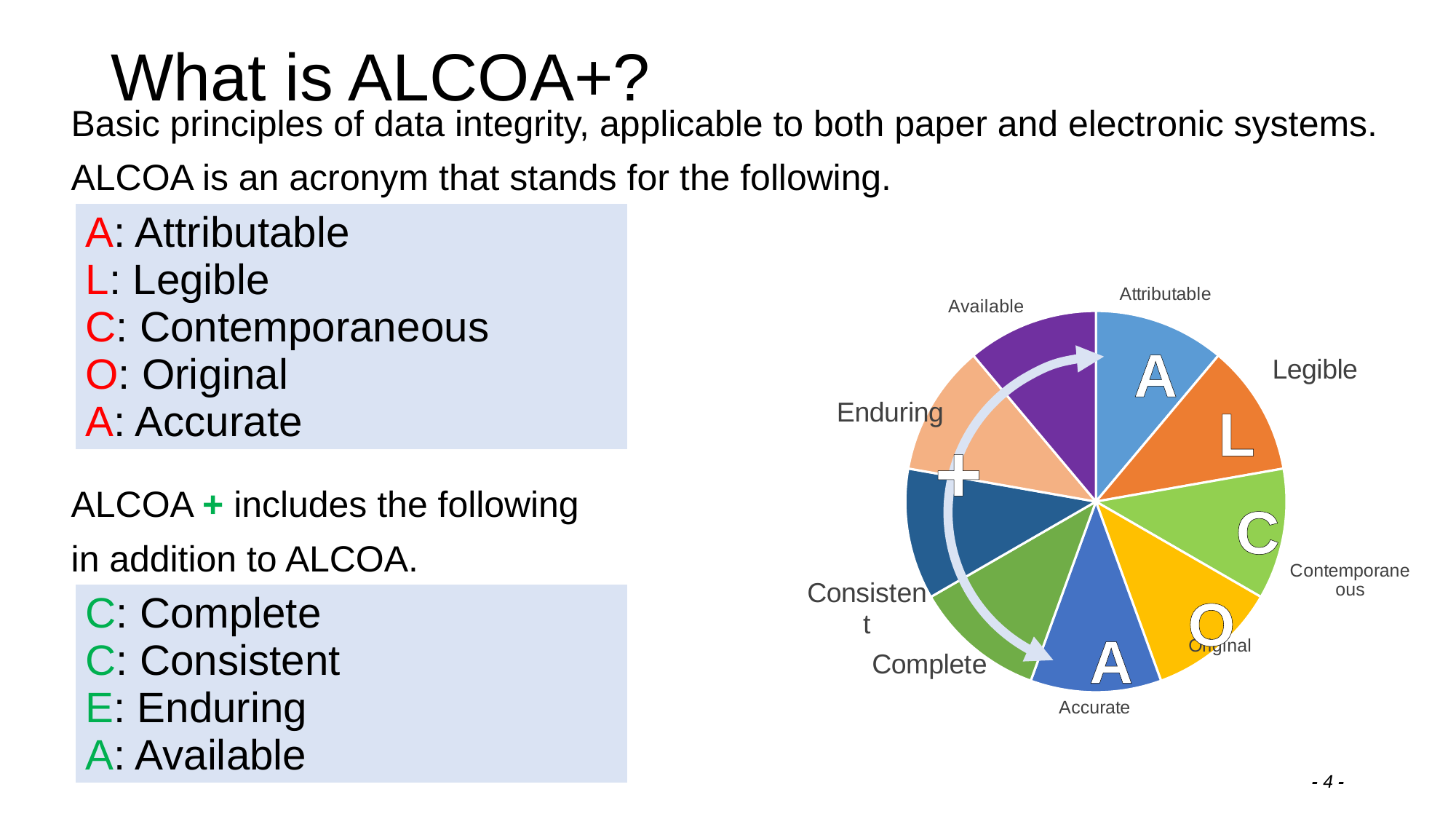
How many slices does the pie chart have? 9 What kind of chart is shown on the right side of the slide? pie chart What colour is the Attributable slice of the pie chart? blue Which slice of the pie chart is labelled Accurate? the blue slice at the bottom Which slice of the pie chart is labelled with the letter L? Legible Which slice of the pie chart sits between Legible and Original? Contemporaneous Which slice of the pie chart is labelled Available? the purple slice